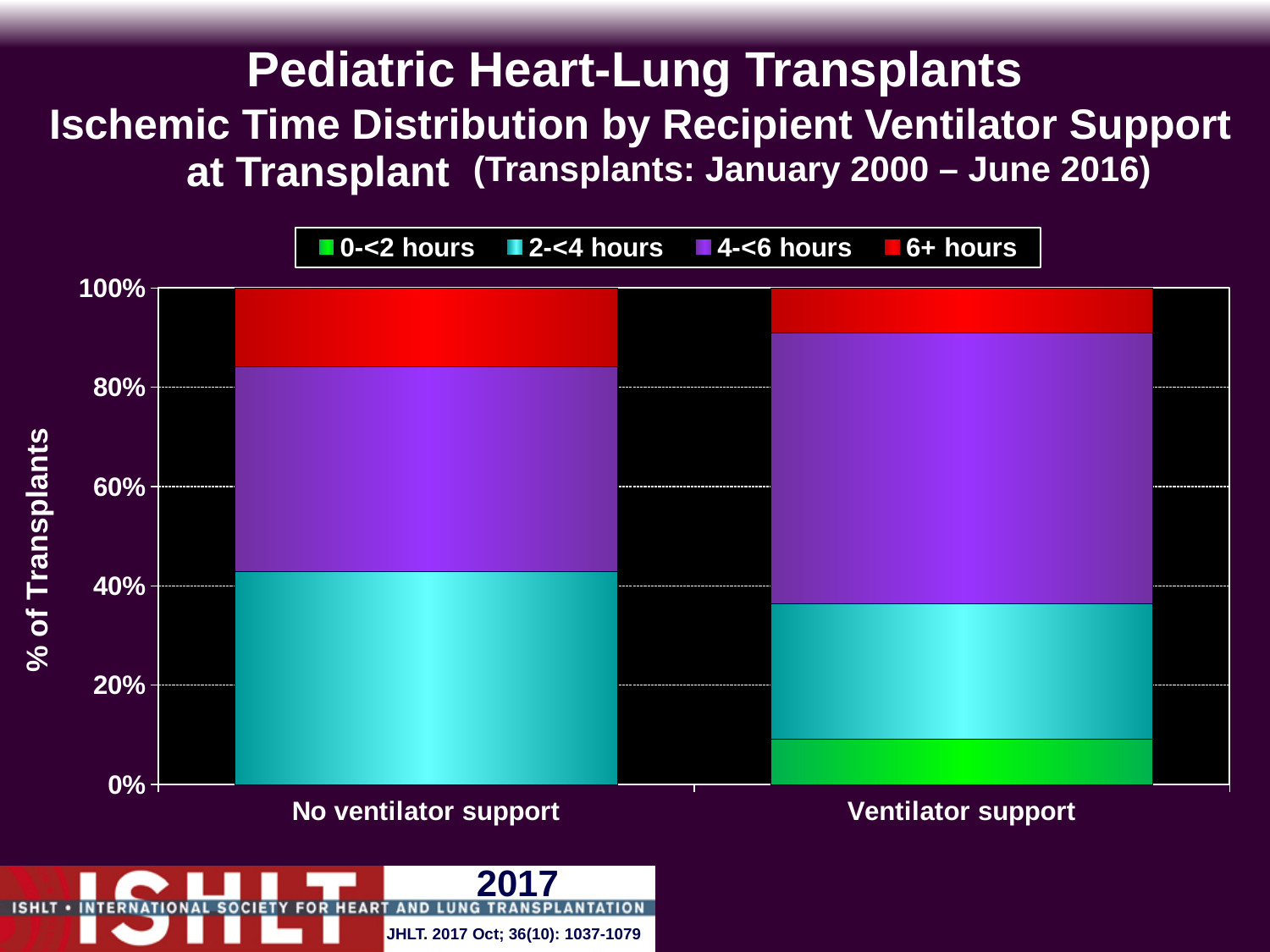
Is the 4-<6 hours share for Ventilator support greater or less than 40%? greater What is the label of the y axis? % of Transplants Is the 0-<2 hours share for Ventilator support greater or less than 20%? less For Ventilator support, which ischemic time category makes up the largest share of the bar? 4-<6 hours What kind of chart is shown on the slide? Stacked bar chart Which category has the larger 2-<4 hours share, No ventilator support or Ventilator support? No ventilator support How many categories are shown on the x axis of the chart? 2 What is the total of the stacked bar for Ventilator support? 100% How many series does the legend list? 4 Is the 6+ hours share for No ventilator support greater or less than 20%? less Which colour represents the 6+ hours series in the legend? Red